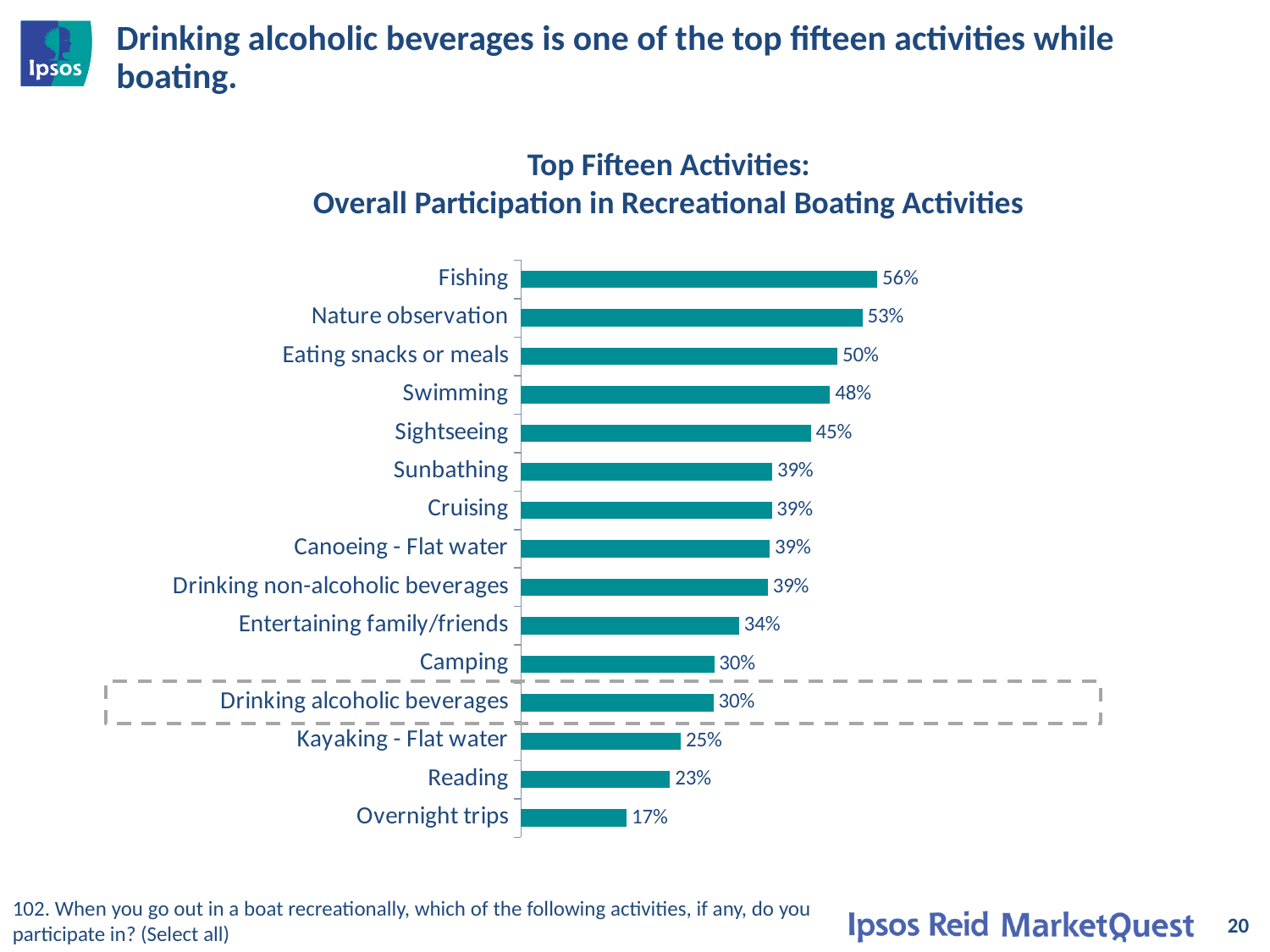
What is the participation rate for Overnight trips? 17% What percentage of respondents participate in fishing while boating? 56% Which has a higher value, Sightseeing or Entertaining family/friends? Sightseeing What is the difference between the values for Fishing and Nature observation? 3% What is the difference between the values for Swimming and Reading? 25% What is the value shown for Drinking alcoholic beverages? 30% How many activities are shown in the chart? 15 What is the title of the chart? Top Fifteen Activities: Overall Participation in Recreational Boating Activities Which activity has the lowest participation rate? Overnight trips Which activity has the highest participation rate? Fishing What type of chart is shown on the slide? Bar chart Which has a higher value, Kayaking - Flat water or Camping? Camping